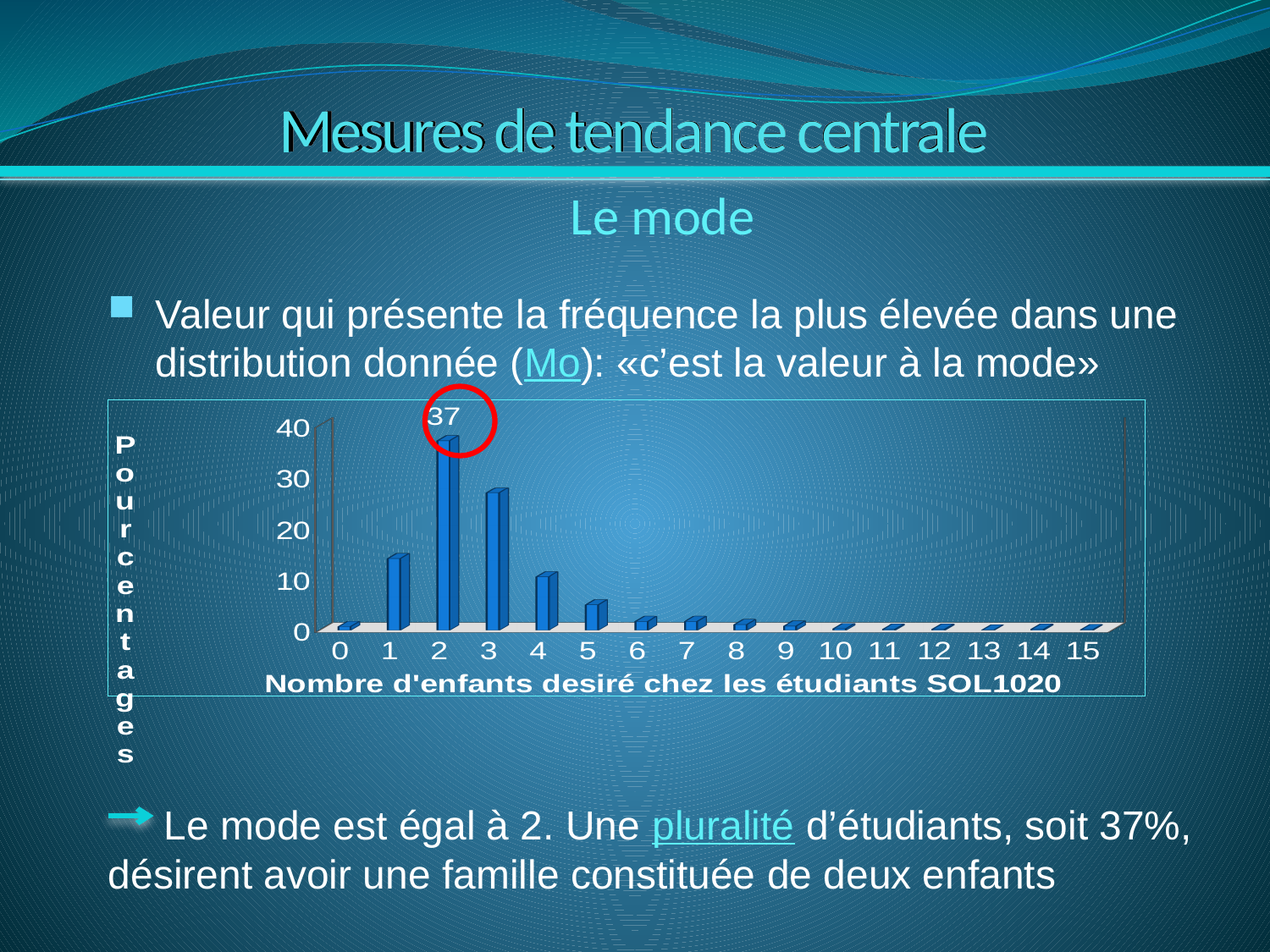
Which category has the highest value on the chart? 2 What is the title of the x axis of the chart? Nombre d'enfants desiré chez les étudiants SOL1020 Which is larger, the value for category 4 or the value for category 5? 4 Is the value for category 1 greater or less than 20? less What kind of chart is shown on the slide? bar chart Is the value for category 4 greater or less than 20? less From category 2 onward, do the values rise or fall along the x axis? fall How many categories are shown on the x axis of the chart? 16 Is the value for category 5 greater or less than 10? less What is the value for category 2 on the chart? 37 Which is larger, the value for category 1 or the value for category 3? 3